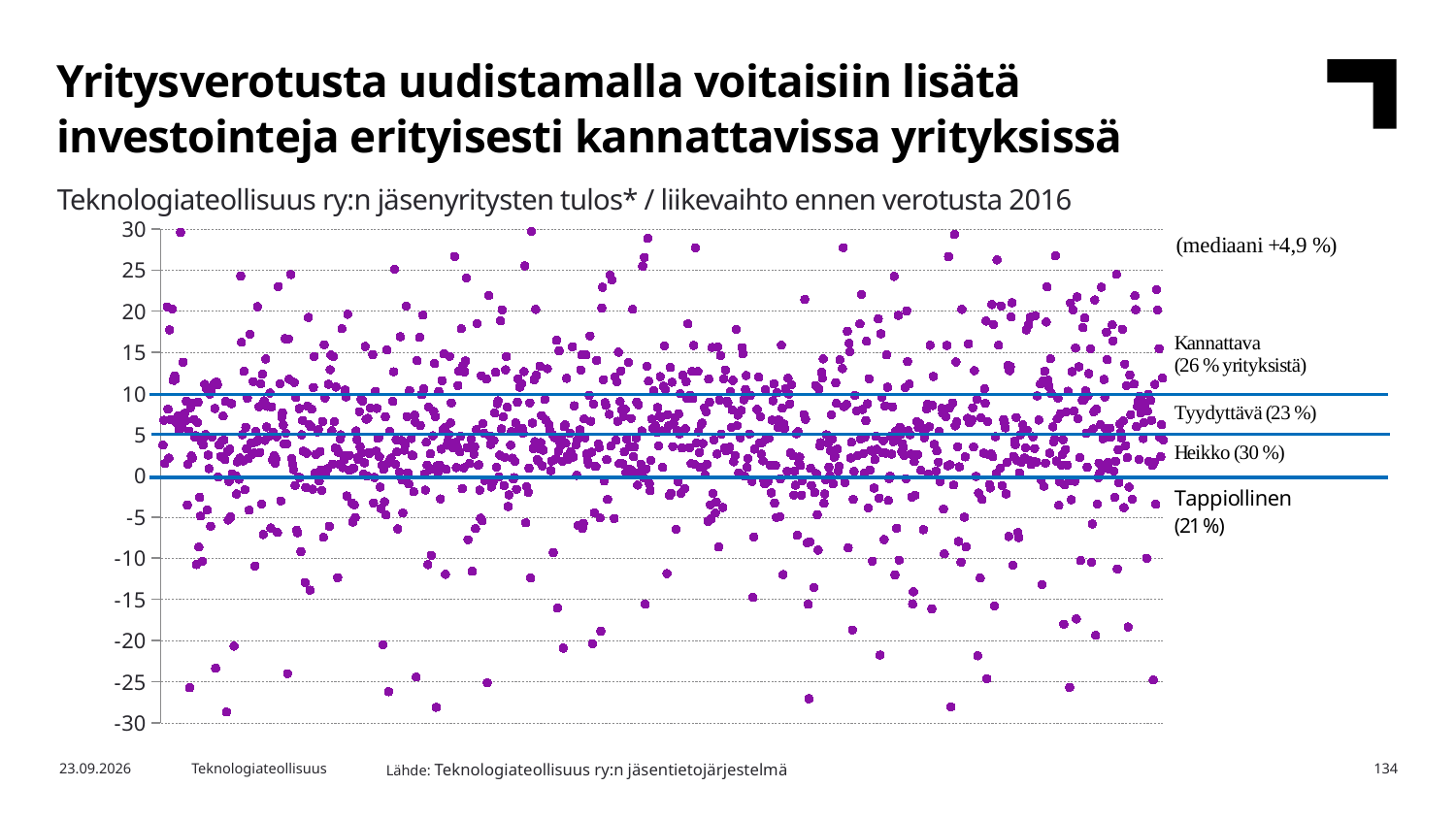
What is the difference in percentage points between the share of companies in Heikko and in Tappiollinen? 9 What share of companies are in the Tyydyttävä category? 23 % What is the highest value shown on the vertical axis? 30 Which profitability category contains the largest share of companies? Heikko Which profitability category contains the smallest share of companies? Tappiollinen What is the subtitle of the chart? Teknologiateollisuus ry:n jäsenyritysten tulos* / liikevaihto ennen verotusta 2016 What share of companies are in the Kannattava category? 26 % What share of companies are in the Tappiollinen category? 21 % What kind of chart is shown on the slide? Scatter chart Which category has a larger share of companies, Kannattava or Tyydyttävä? Kannattava What is the median value of tulos / liikevaihto given on the chart? +4,9 % What share of companies are in the Heikko category? 30 %